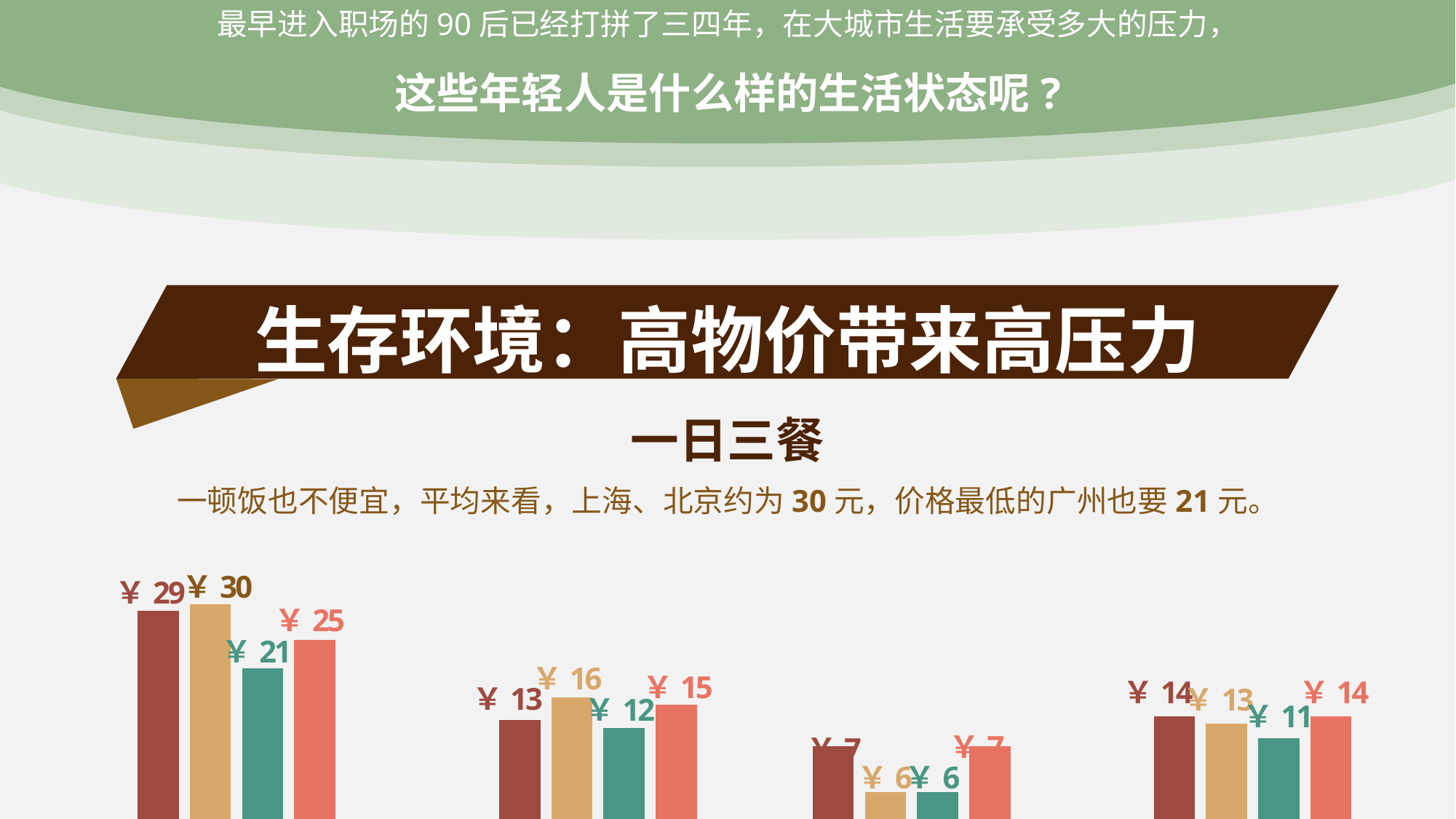
How many groups of bars does the chart contain? 4 What is the highest value shown anywhere on the chart? ¥ 30 In the leftmost group of bars, which bar has the lowest value? the teal (third) bar, ¥ 21 In the second group of bars from the left, which is larger: the dark red bar or the salmon bar? the salmon bar (¥ 15) In the leftmost group, what is the difference between the tan bar and the teal bar? 9 In the leftmost group of bars, what is the value of the tan (second) bar? ¥ 30 How many bars are in each group of the chart? 4 In the third group of bars from the left, what is the value of the dark red (first) bar? ¥ 7 What kind of chart is shown on the slide? bar chart In the second group of bars from the left, what is the value of the tan bar? ¥ 16 In the rightmost group of bars, what is the value of the teal bar? ¥ 11 In the leftmost group of bars, what is the value of the teal (third) bar? ¥ 21